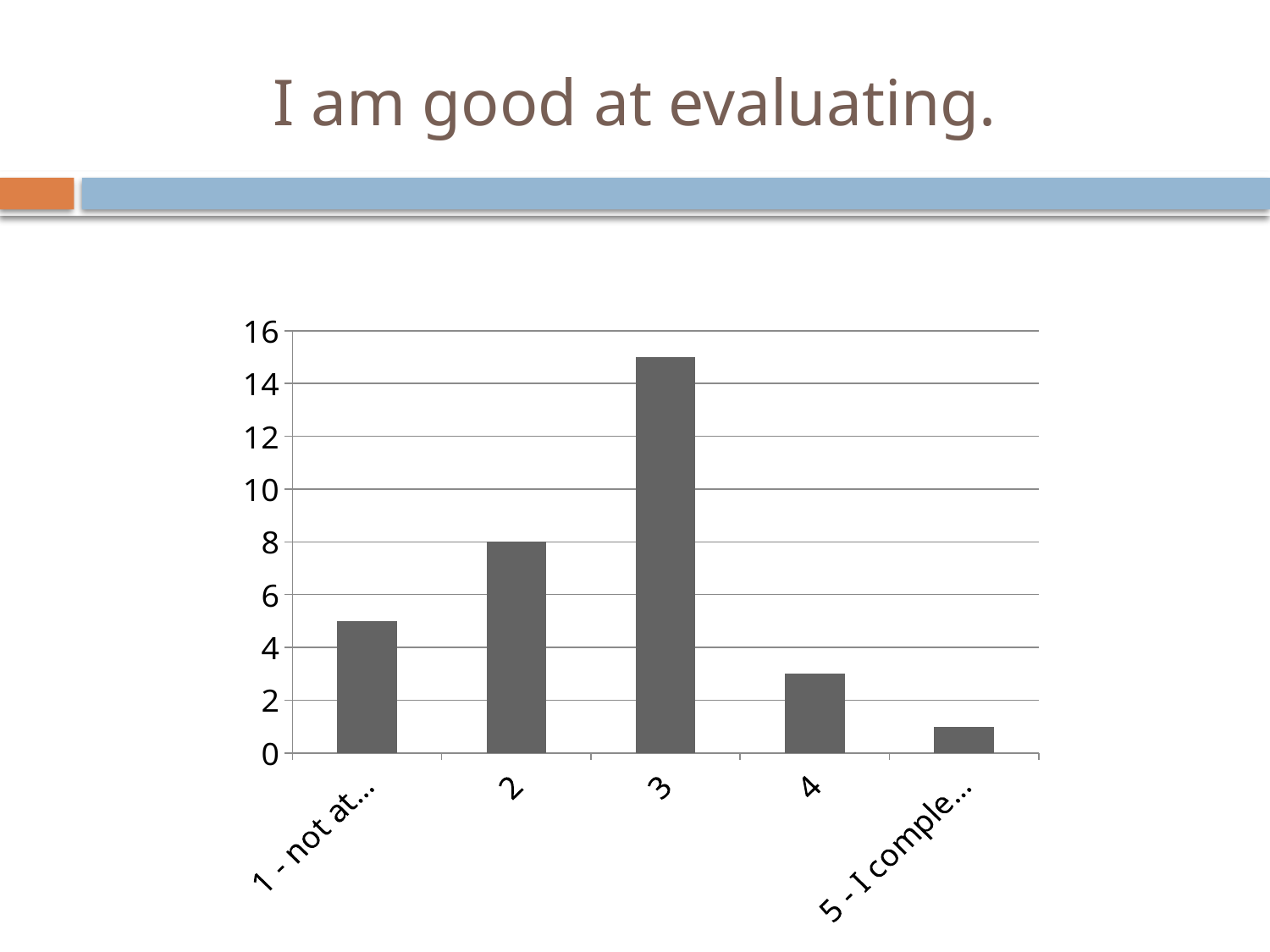
Is the value for category 4 greater or less than 4? less What is the title of the slide containing the chart? I am good at evaluating. Is the value for the last category (5 - I comple...) greater or less than 2? less Which category has the lowest bar in the chart? 5 - I comple... What is the value for category 2 in the chart? 8 Is the value for category 3 greater or less than 14? greater How many categories are shown on the x axis of the chart? 5 Which has the larger value, category 2 or category 4? 2 Which category has the highest bar in the chart? 3 What kind of chart is shown on the slide? bar chart Do the values rise or fall from category 3 to category 5? fall